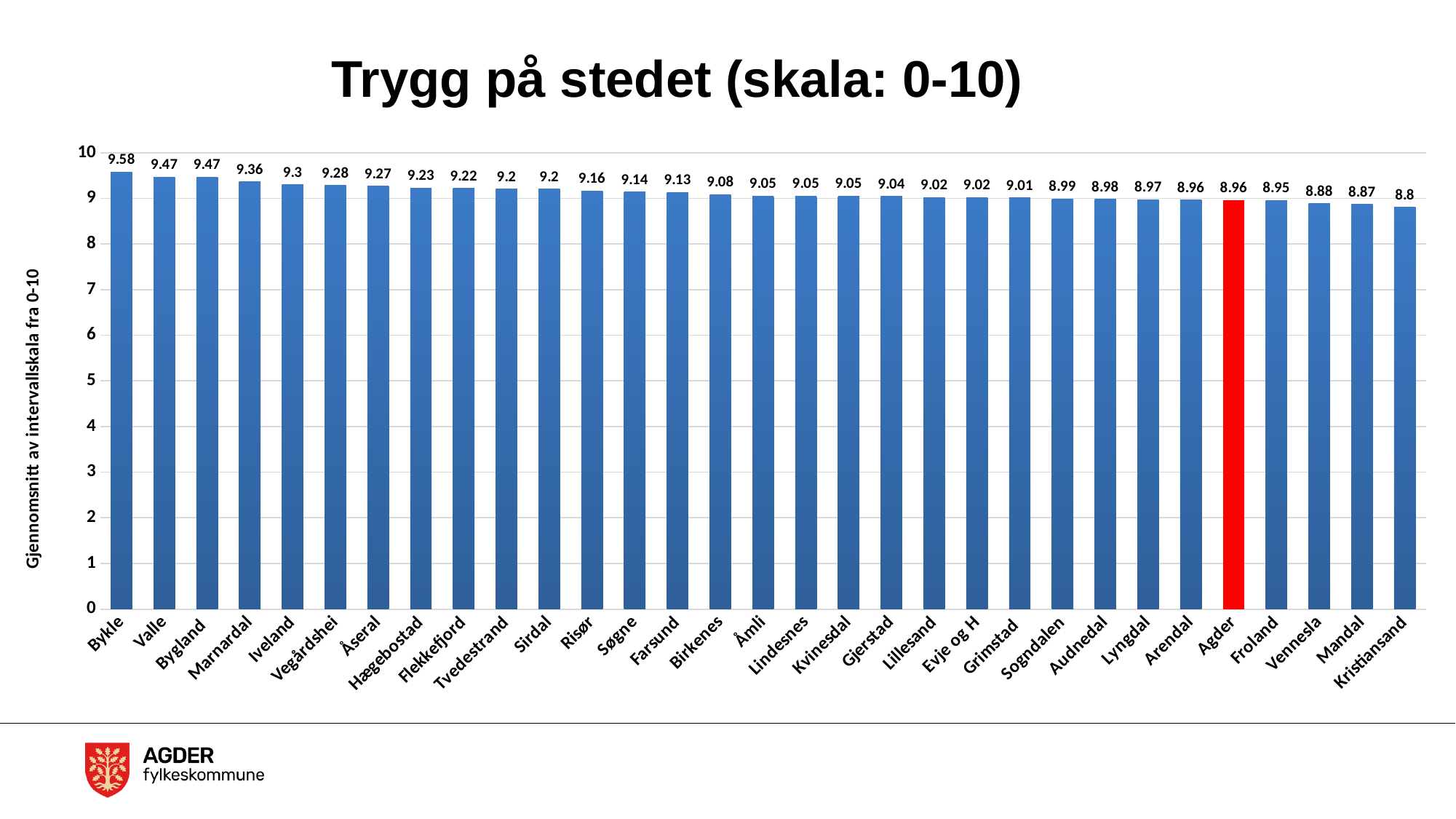
What kind of chart is shown? Bar chart What is the difference between the values for Marnardal and Agder? 0.4 What is the value for Bykle? 9.58 What is the value for Flekkefjord? 9.22 What is the value for Kristiansand? 8.8 What is the value for Agder? 8.96 Which category has the lowest value? Kristiansand Which has a larger value, Iveland or Vennesla? Iveland What is the difference between the values for Bykle and Kristiansand? 0.78 What is the title of the chart? Trygg på stedet (skala: 0-10) Which category has the highest value? Bykle How many categories are shown on the x axis? 31